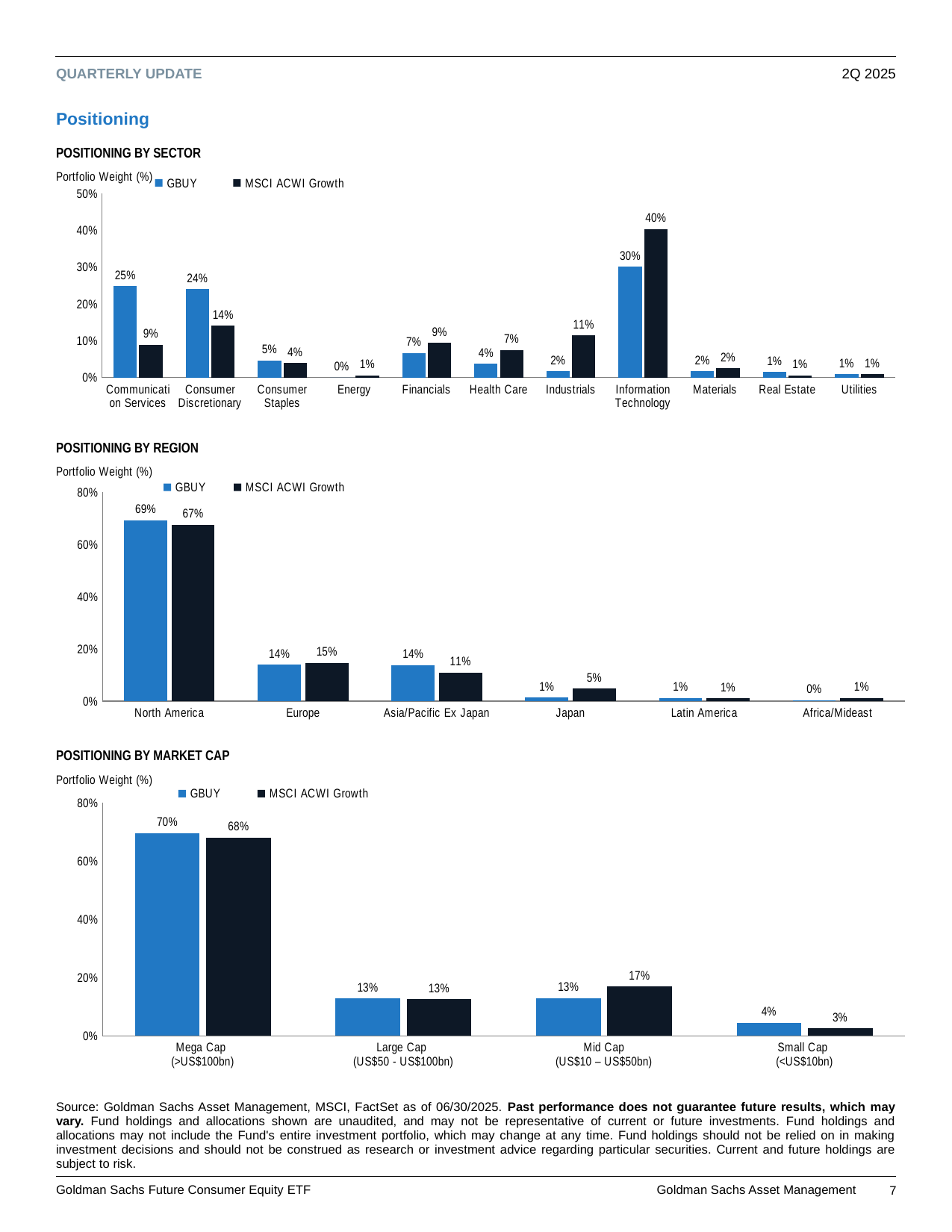
What type of chart is the Positioning by Market Cap chart? Bar chart In the Positioning by Region chart, which region has the lowest GBUY weight? Africa/Mideast In the Positioning by Sector chart, how many sectors are shown on the x axis? 11 In the Positioning by Sector chart, what is the GBUY weight for Communication Services? 25% In the Positioning by Region chart, which is larger for Japan, the GBUY weight or the MSCI ACWI Growth weight? MSCI ACWI Growth In the Positioning by Sector chart, what is the MSCI ACWI Growth weight for Information Technology? 40% In the Positioning by Market Cap chart, what is the difference between the GBUY and MSCI ACWI Growth weights for Mega Cap? 2% In the Positioning by Region chart, what is the GBUY weight for North America? 69% In the Positioning by Sector chart, which sector has the highest GBUY weight? Information Technology In the Positioning by Sector chart, what is the difference between the GBUY and MSCI ACWI Growth weights for Consumer Discretionary? 10% In the Positioning by Market Cap chart, how many series does the legend list? 2 In the Positioning by Market Cap chart, what is the MSCI ACWI Growth weight for Mid Cap? 17%